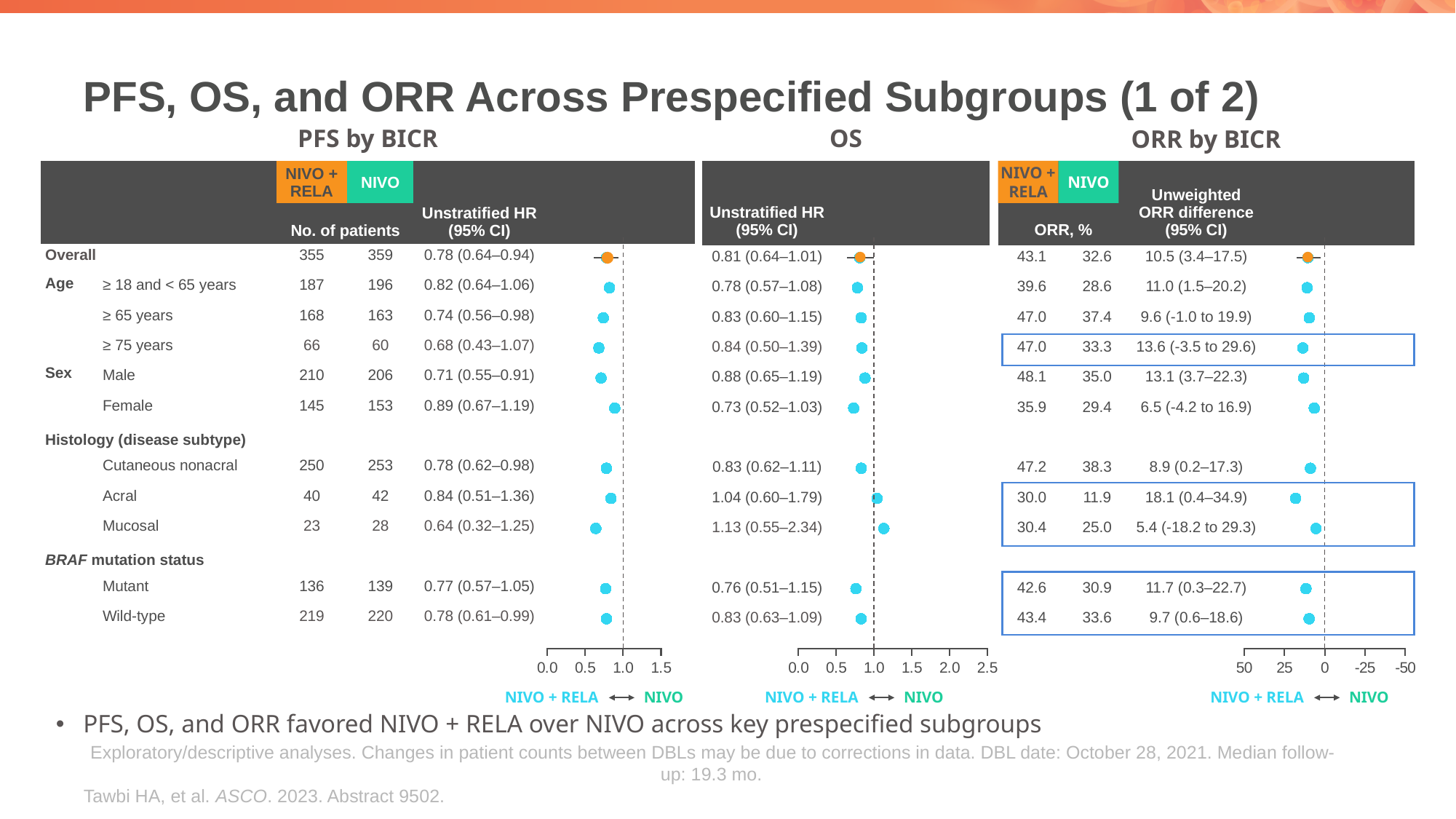
In the ORR by BICR chart, which subgroup has the largest unweighted ORR difference? Acral In the ORR by BICR chart, what is the difference between the NIVO + RELA ORR and the NIVO ORR for the Female subgroup? 6.5 In the PFS by BICR chart, which has the larger unstratified HR, Male or Female? Female In the PFS by BICR chart, how many NIVO + RELA patients are in the Overall group? 355 In the PFS by BICR chart, what is the unstratified HR (95% CI) for the Overall group? 0.78 (0.64–0.94) In the OS chart, is the unstratified HR for the Mucosal subgroup greater or less than 1.0? greater In the ORR by BICR chart, which subgroup has the smallest unweighted ORR difference? Mucosal In the ORR by BICR chart, what is the ORR, % for NIVO + RELA in the Male subgroup? 48.1 In the ORR by BICR chart, what is the unweighted ORR difference (95% CI) for the Overall group? 10.5 (3.4–17.5) In the OS chart, which subgroup has the highest unstratified HR? Mucosal In the OS chart, what is the unstratified HR (95% CI) for the Acral subgroup? 1.04 (0.60–1.79) In the PFS by BICR chart, which subgroup has the lowest unstratified HR? Mucosal